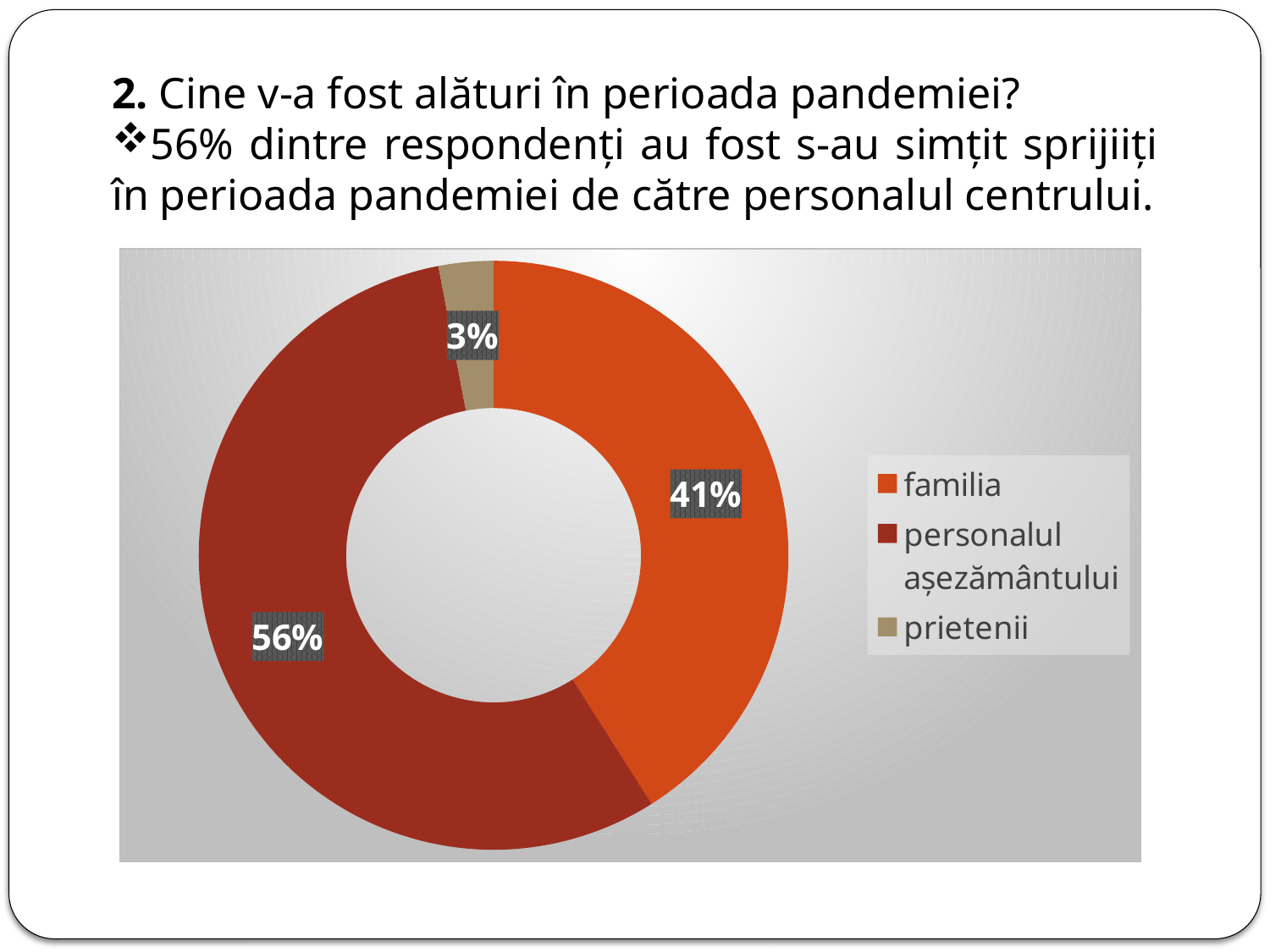
What is the difference in percentage points between familia and prietenii? 38 What share of the pie does familia represent? 41% What share of the pie does prietenii represent? 3% How many categories are shown in the chart? 3 What colour is the slice for familia? orange What kind of chart is shown on the slide? doughnut chart Which is larger, the slice for familia or the slice for prietenii? familia Which category has the smallest slice of the pie? prietenii Which category has the largest slice of the pie? personalul așezământului What share of the pie does personalul așezământului represent? 56% Which legend entry is listed last? prietenii What is the difference in percentage points between personalul așezământului and familia? 15